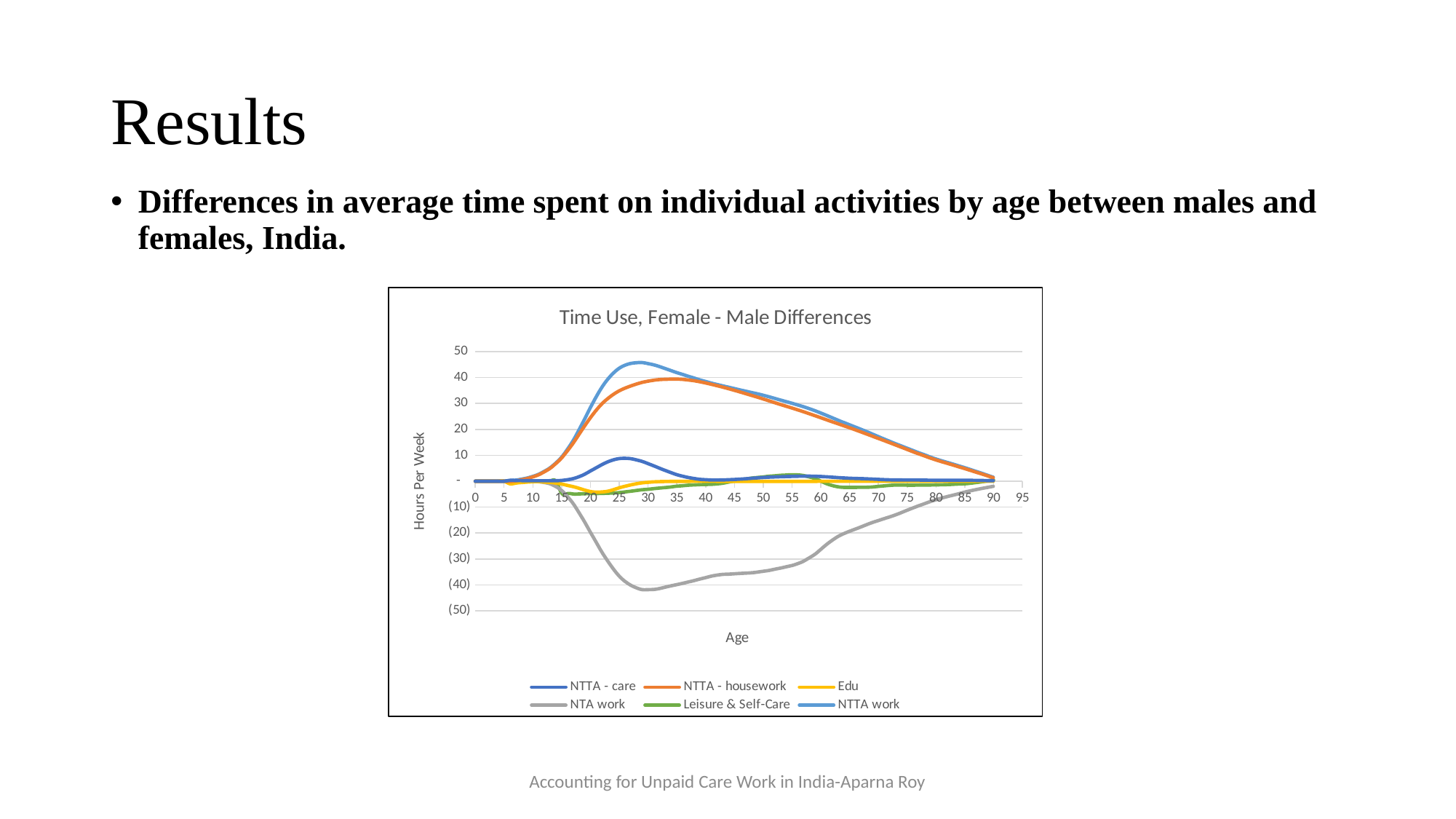
What is the label of the vertical axis of the chart? Hours Per Week Is the peak value of the NTTA work series greater or less than 40? greater What is the title of the chart? Time Use, Female - Male Differences Is the peak value of the NTTA - care series greater or less than 20? less What kind of chart is shown on the slide? line chart Does the NTTA - housework series rise or fall between age 35 and age 90? fall Is the value of the NTTA - housework series at age 35 greater or less than 30? greater Which series reaches the highest value on the chart? NTTA work How many series does the legend of the chart list? 6 Which series reaches the lowest value on the chart? NTA work At age 25, which is larger: the NTTA work series or the NTTA - housework series? NTTA work